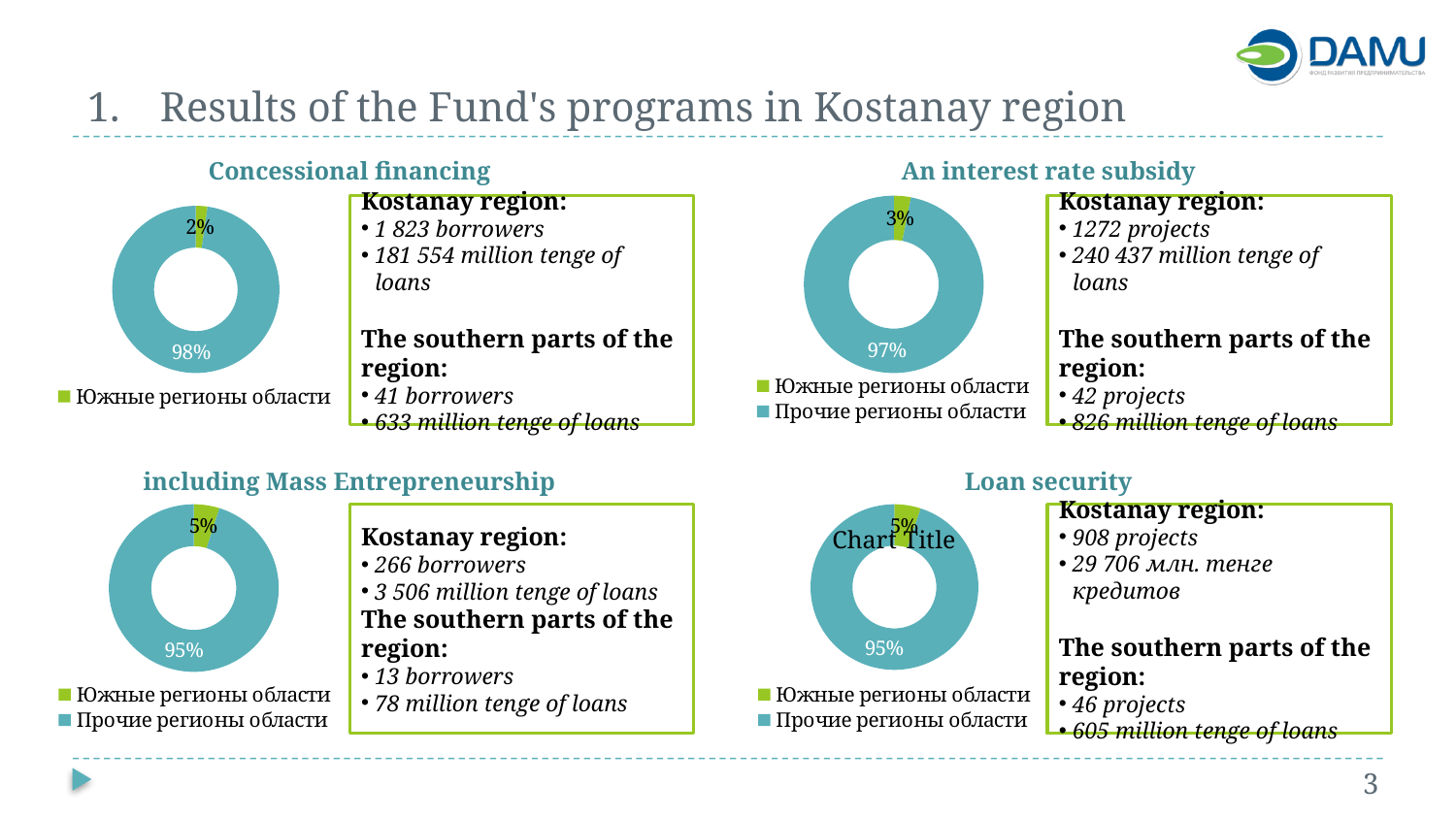
How many slices does the 'including Mass Entrepreneurship' chart have? 2 In the 'Concessional financing' chart, what share is shown for the 'Южные регионы области' slice? 2% What type of chart is used under 'Concessional financing'? Donut (pie) chart In the 'An interest rate subsidy' chart, what share is shown for 'Южные регионы области'? 3% How many entries does the legend of the 'Loan security' chart list? 2 In the 'An interest rate subsidy' chart, what is the difference in percentage points between the two slices? 94 In the 'Loan security' chart, what share is shown for 'Прочие регионы области'? 95% In the 'Concessional financing' chart, what share is shown for the larger slice? 98% In the 'An interest rate subsidy' chart, which slice is larger, 'Южные регионы области' or 'Прочие регионы области'? Прочие регионы области In the 'including Mass Entrepreneurship' chart, what share is shown for 'Южные регионы области'? 5% What placeholder title text appears over the 'Loan security' chart? Chart Title In the 'An interest rate subsidy' chart, what share is shown for 'Прочие регионы области'? 97%